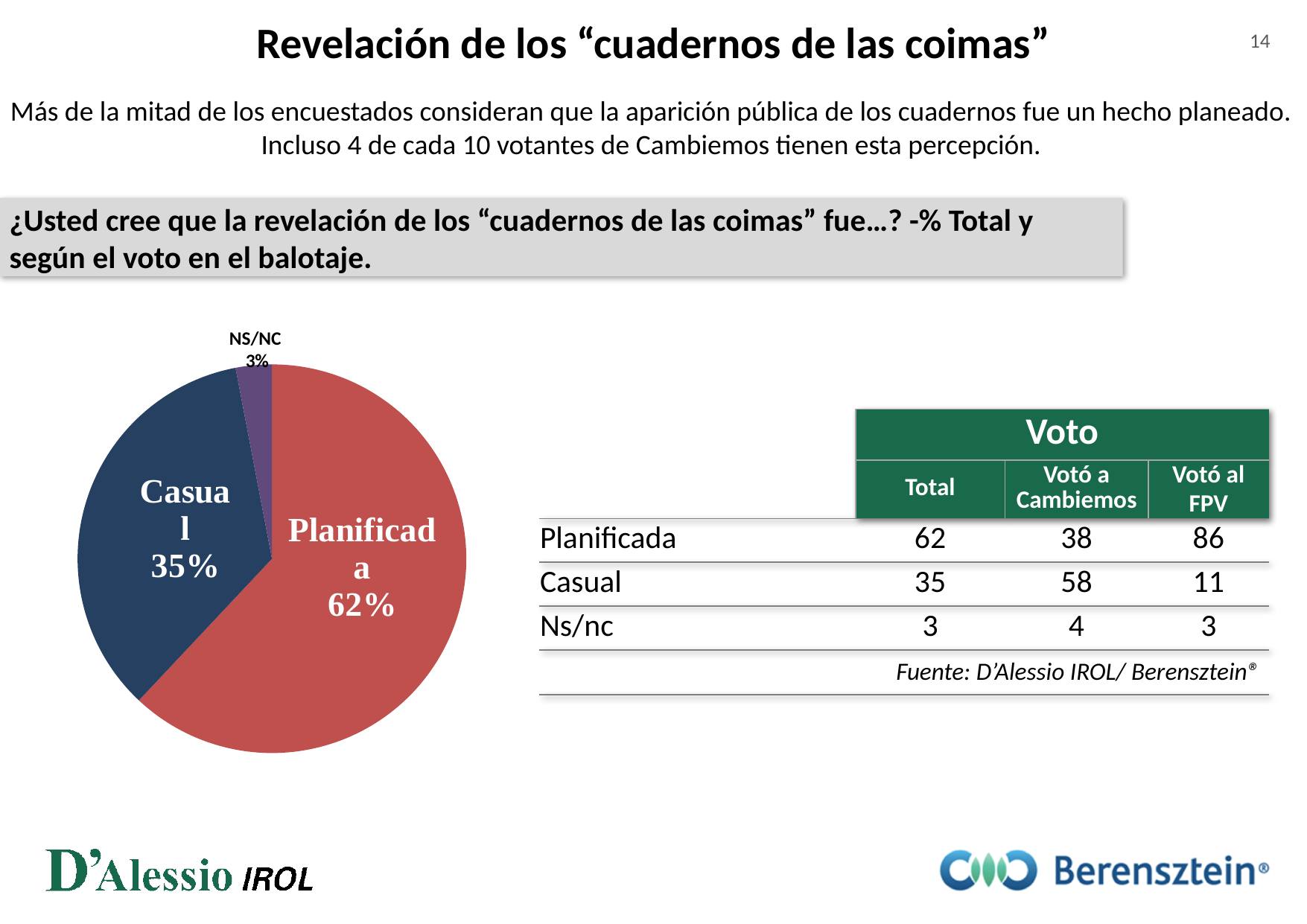
What share of the pie chart is labelled NS/NC? 3% What is the difference in percentage points between the Planificada and Casual slices of the pie chart? 27 Which slice of the pie chart is the largest? Planificada What share of the pie chart is labelled Planificada? 62% How many slices does the pie chart have? 3 What kind of chart is shown on the slide? pie chart Which slice of the pie chart is the smallest? NS/NC What colour is the Planificada slice of the pie chart? red What colour is the Casual slice of the pie chart? dark blue What share of the pie chart is labelled Casual? 35% Which slice of the pie chart is larger, Casual or NS/NC? Casual